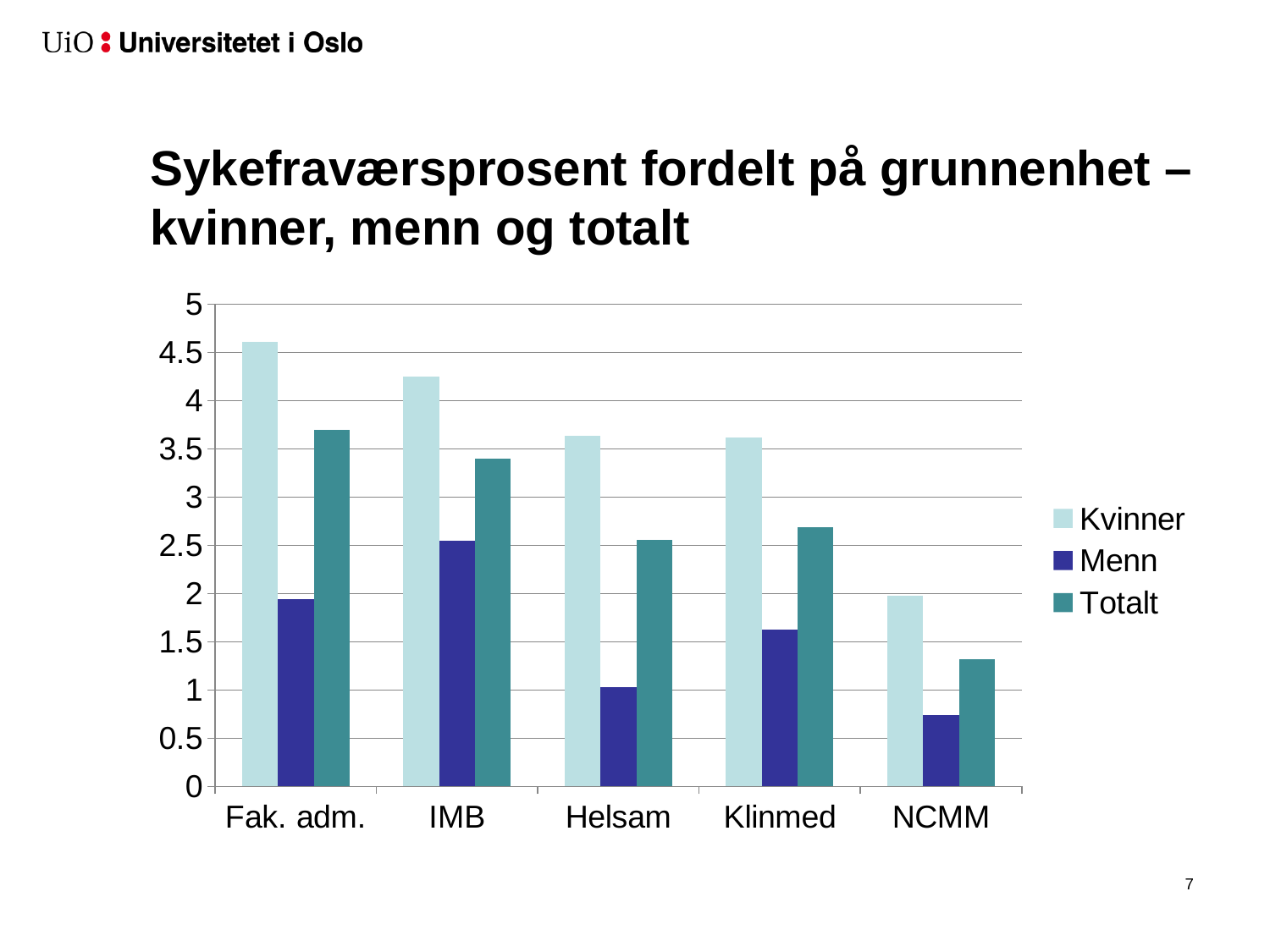
Which is larger, the Totalt value for Fak. adm. or the Totalt value for IMB? Fak. adm. Which category has the highest Menn value? IMB How many series does the legend list? 3 What kind of chart is shown on the slide? Bar chart How many categories are shown on the x axis? 5 Which category has the highest Kvinner value? Fak. adm. Is the Kvinner value for Fak. adm. greater or less than 4.5? greater Is the Totalt value for NCMM greater or less than 1.5? less Is the Menn value for Helsam greater or less than 1.5? less Which is larger, the Menn value for Klinmed or the Menn value for Helsam? Klinmed Which series is shown in the darkest blue bars? Menn Which category has the lowest Totalt value? NCMM